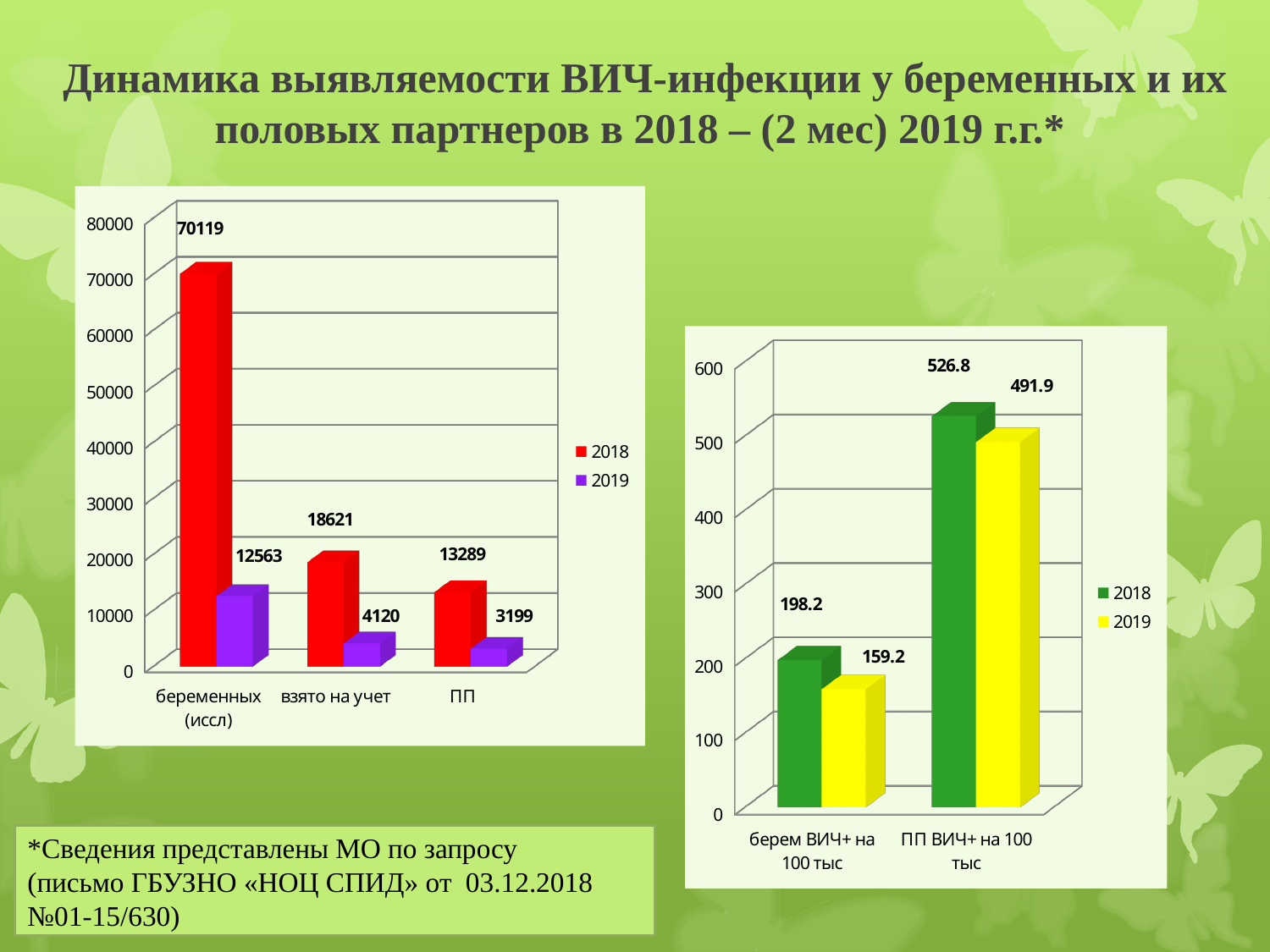
In the left chart, which category has the highest 2018 value? беременных (иссл) In the right chart, what is the difference between the 2018 and 2019 values for ПП ВИЧ+ на 100 тыс? 34.9 In the right chart, what is the 2018 value for ПП ВИЧ+ на 100 тыс? 526.8 In the right chart, which is larger: the 2018 value for берем ВИЧ+ на 100 тыс or the 2019 value for берем ВИЧ+ на 100 тыс? 2018 In the left chart, how many categories are shown on the x axis? 3 What type of chart is the left chart? bar chart In the left chart, what is the 2019 value for взято на учет? 4120 How many series does the legend of the right chart list? 2 In the left chart, what is the 2018 value for беременных (иссл)? 70119 In the left chart, what is the 2019 value for ПП? 3199 In the right chart, what is the 2019 value for берем ВИЧ+ на 100 тыс? 159.2 In the left chart, what is the difference between the 2018 and 2019 values for взято на учет? 14501